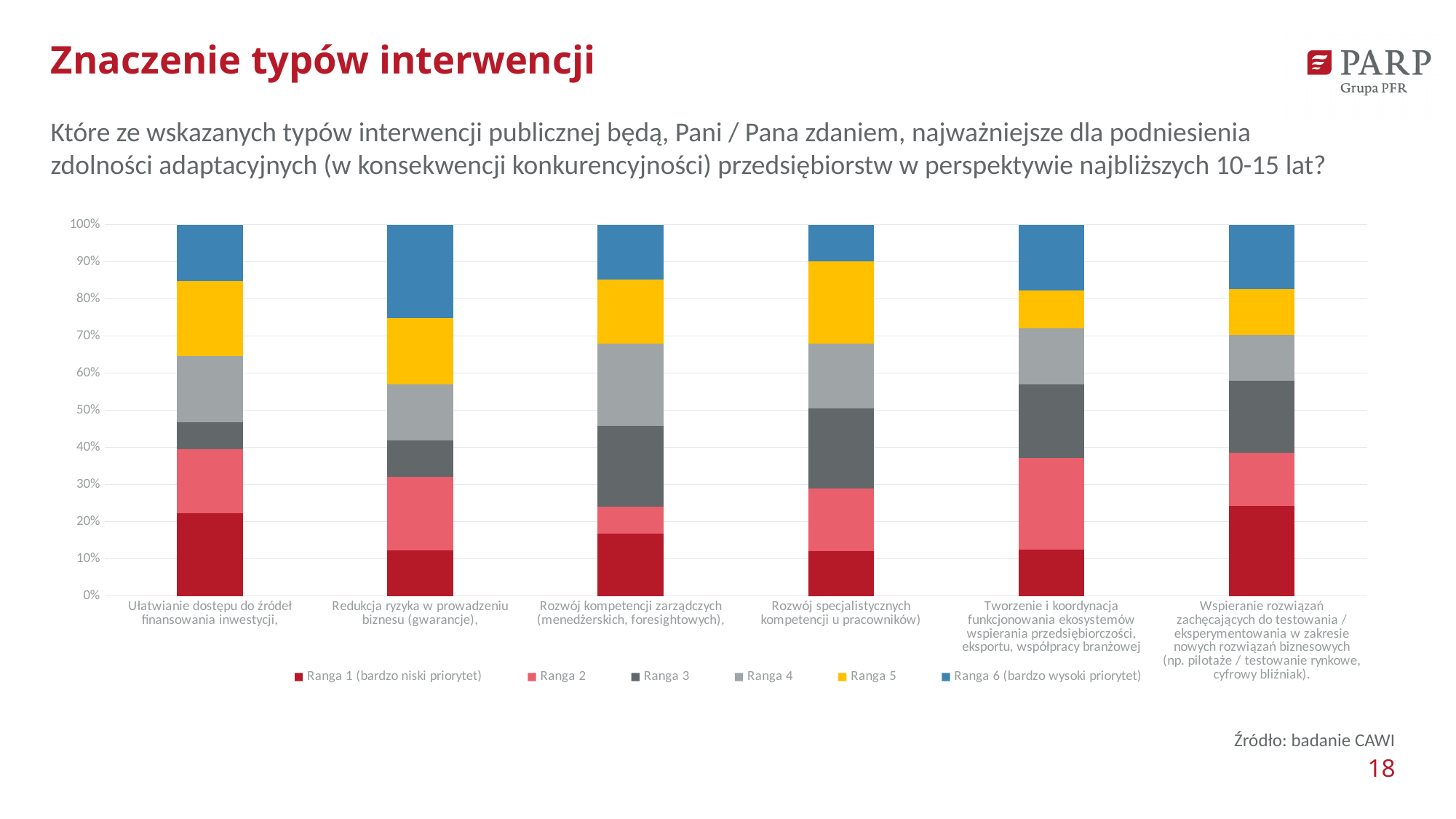
What colour represents Ranga 5 in the chart legend? Yellow Is the Ranga 1 share for 'Ułatwianie dostępu do źródeł finansowania inwestycji' greater or less than 20%? greater How many intervention types (categories) are shown on the x axis of the chart? 6 Which intervention type has the largest Ranga 6 (bardzo wysoki priorytet) share? Redukcja ryzyka w prowadzeniu biznesu (gwarancje) Is the Ranga 6 (bardzo wysoki priorytet) share for 'Redukcja ryzyka w prowadzeniu biznesu (gwarancje)' greater or less than 20%? greater Is the Ranga 6 (bardzo wysoki priorytet) share for 'Rozwój specjalistycznych kompetencji u pracowników' greater or less than 20%? less Which intervention type has the smallest Ranga 2 share? Rozwój kompetencji zarządczych (menedżerskich, foresightowych) What kind of chart is shown on the slide? Stacked bar chart Which has the larger Ranga 1 share: 'Wspieranie rozwiązań zachęcających do testowania / eksperymentowania...' or 'Redukcja ryzyka w prowadzeniu biznesu (gwarancje)'? Wspieranie rozwiązań zachęcających do testowania / eksperymentowania... Which has the larger Ranga 2 share: 'Tworzenie i koordynacja funkcjonowania ekosystemów...' or 'Rozwój kompetencji zarządczych (menedżerskich, foresightowych)'? Tworzenie i koordynacja funkcjonowania ekosystemów... How many series does the chart legend list? 6